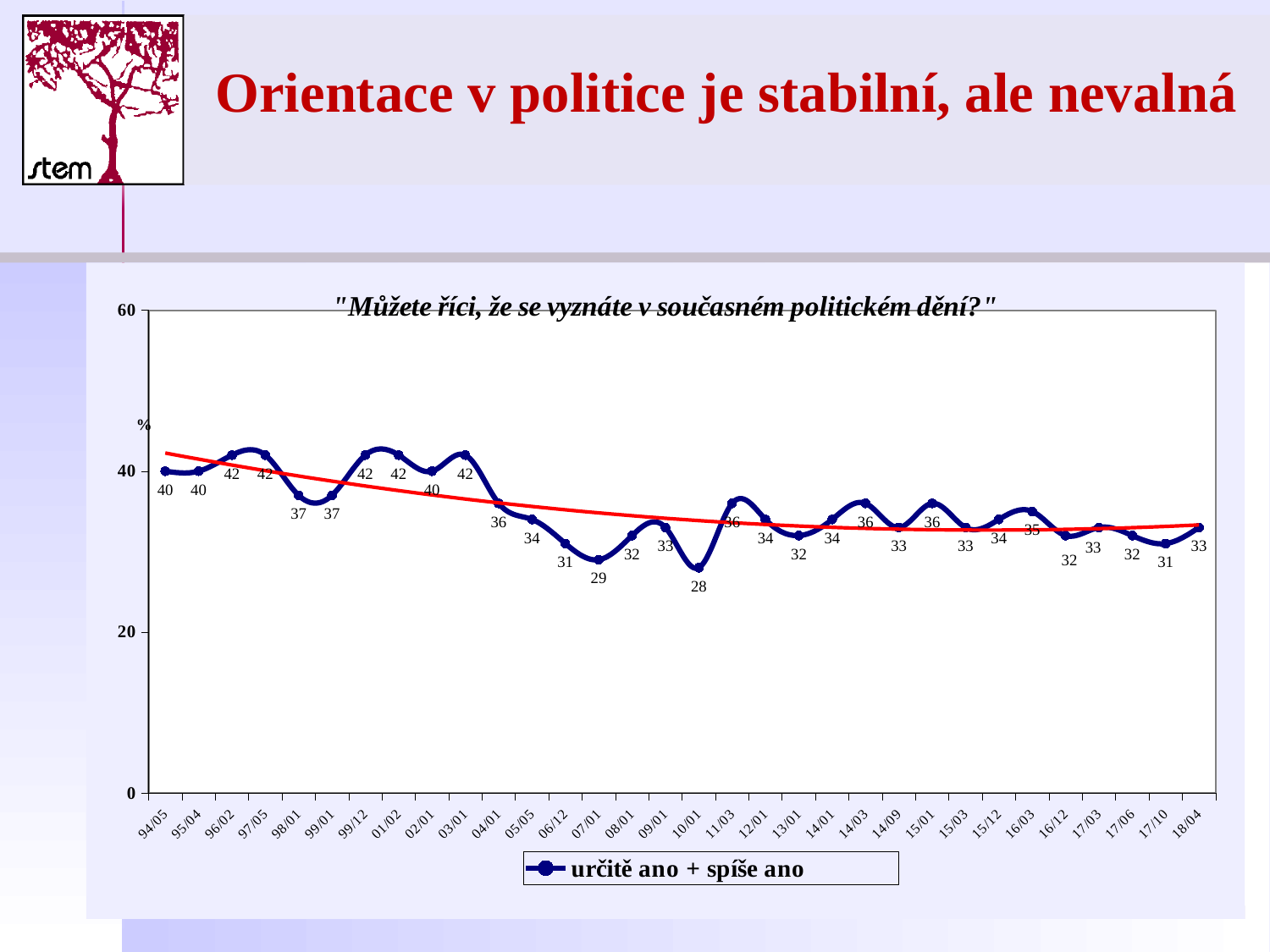
What is the value for 98/01? 37 How many data points are plotted on the chart? 32 What is the value for 94/05? 40 Which has the larger value, 07/01 or 11/03? 11/03 How many series does the legend list? 1 Which point on the x axis has the lowest value? 10/01 What is the difference between the value for 94/05 and the value for 18/04? 7 What is the value for 18/04? 33 What is the legend entry for the plotted series? určitě ano + spíše ano What kind of chart is shown on the slide? line chart What is the value for 10/01? 28 Do the values generally rise or fall from 94/05 to 18/04? fall